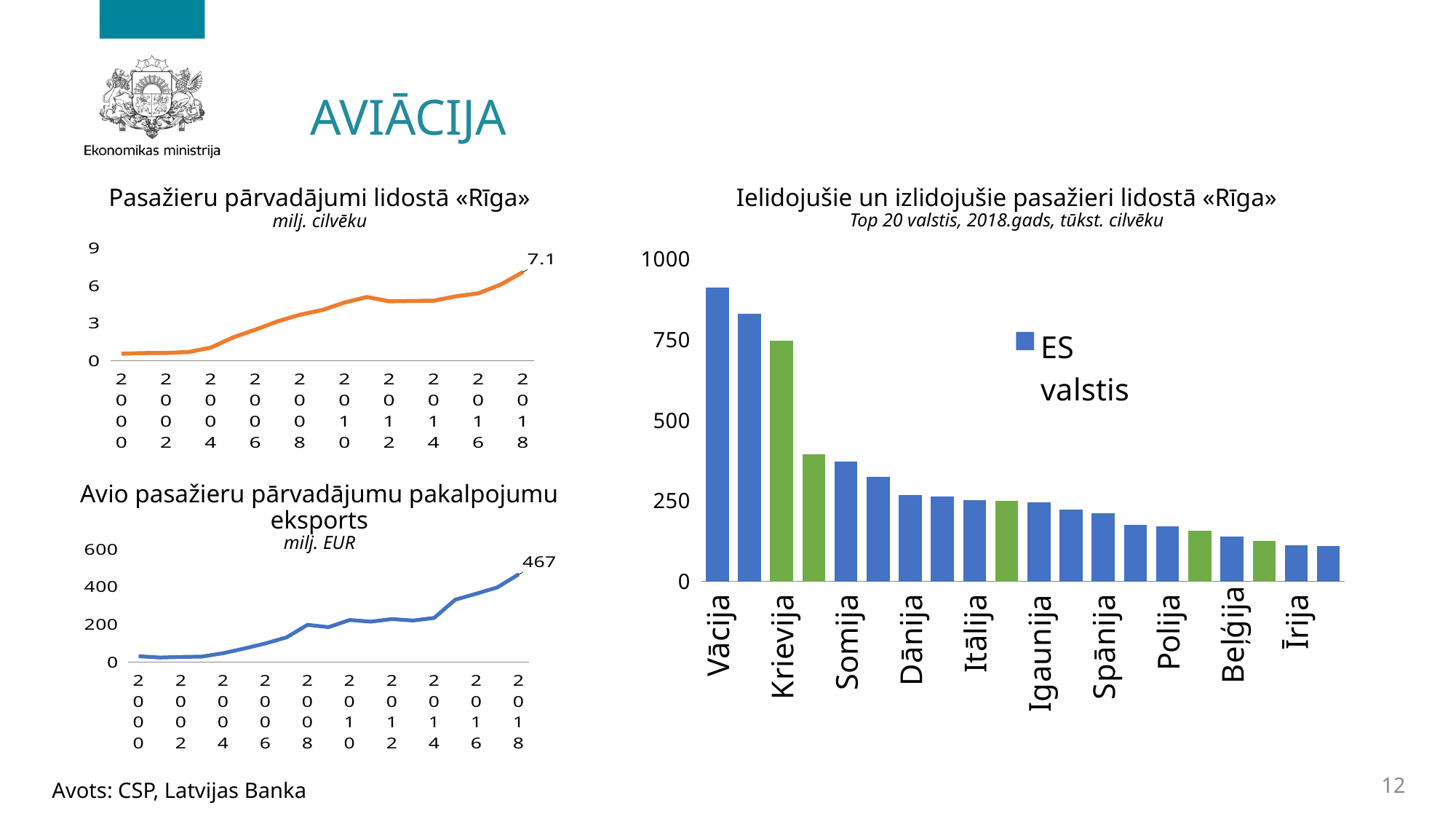
In the chart 'Ielidojušie un izlidojušie pasažieri lidostā «Rīga»', what legend entry is shown for the blue bars? ES valstis In the chart 'Pasažieru pārvadājumi lidostā «Rīga»', what value is labelled for 2018? 7.1 In the chart 'Ielidojušie un izlidojušie pasažieri lidostā «Rīga»', which country has the highest value? Vācija In the chart 'Avio pasažieru pārvadājumu pakalpojumu eksports', do the values generally rise or fall from 2000 to 2018? rise In the chart 'Ielidojušie un izlidojušie pasažieri lidostā «Rīga»', is the value for Vācija greater or less than 750? greater How many bars are plotted in the chart 'Ielidojušie un izlidojušie pasažieri lidostā «Rīga»'? 20 What kind of chart is 'Ielidojušie un izlidojušie pasažieri lidostā «Rīga»'? bar chart In the chart 'Avio pasažieru pārvadājumu pakalpojumu eksports', what value is labelled for 2018? 467 In the chart 'Ielidojušie un izlidojušie pasažieri lidostā «Rīga»', is the value for Somija greater or less than 500? less In the chart 'Ielidojušie un izlidojušie pasažieri lidostā «Rīga»', which is larger, the value for Somija or the value for Spānija? Somija What kind of chart is 'Pasažieru pārvadājumi lidostā «Rīga»'? line chart In the chart 'Ielidojušie un izlidojušie pasažieri lidostā «Rīga»', is the value for Polija greater or less than 250? less